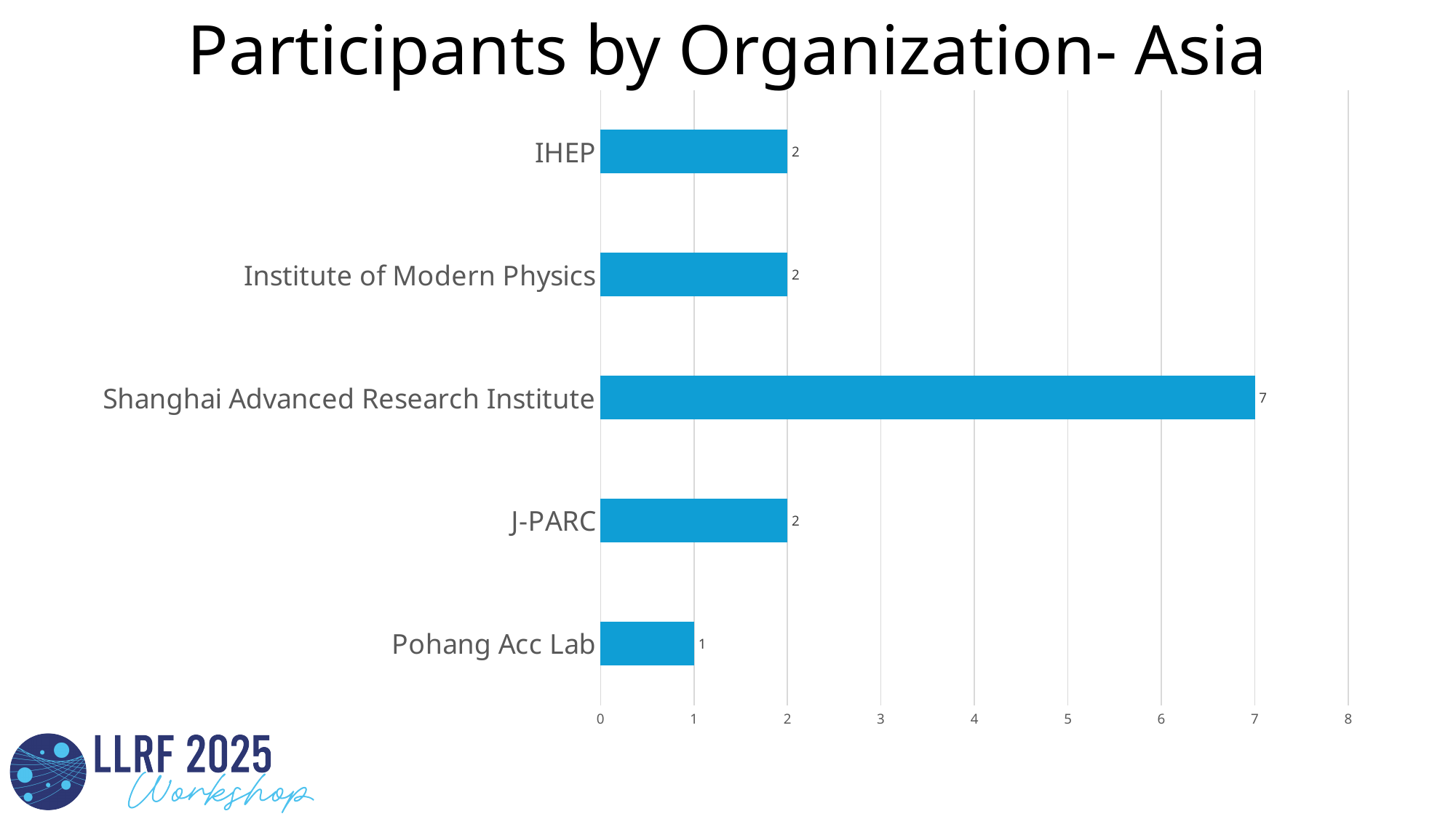
What is the difference between the values for Shanghai Advanced Research Institute and Institute of Modern Physics? 5 Which organization has the lowest number of participants? Pohang Acc Lab What is the value for Pohang Acc Lab? 1 Which organization has the highest number of participants? Shanghai Advanced Research Institute How many organizations are shown in the chart? 5 What is the value for IHEP? 2 What is the title of the chart? Participants by Organization- Asia Which has more participants, J-PARC or Pohang Acc Lab? J-PARC How many participants are shown for Shanghai Advanced Research Institute? 7 Is the value for Shanghai Advanced Research Institute greater or less than 5? greater What is the value for J-PARC? 2 What kind of chart is shown on the slide? bar chart